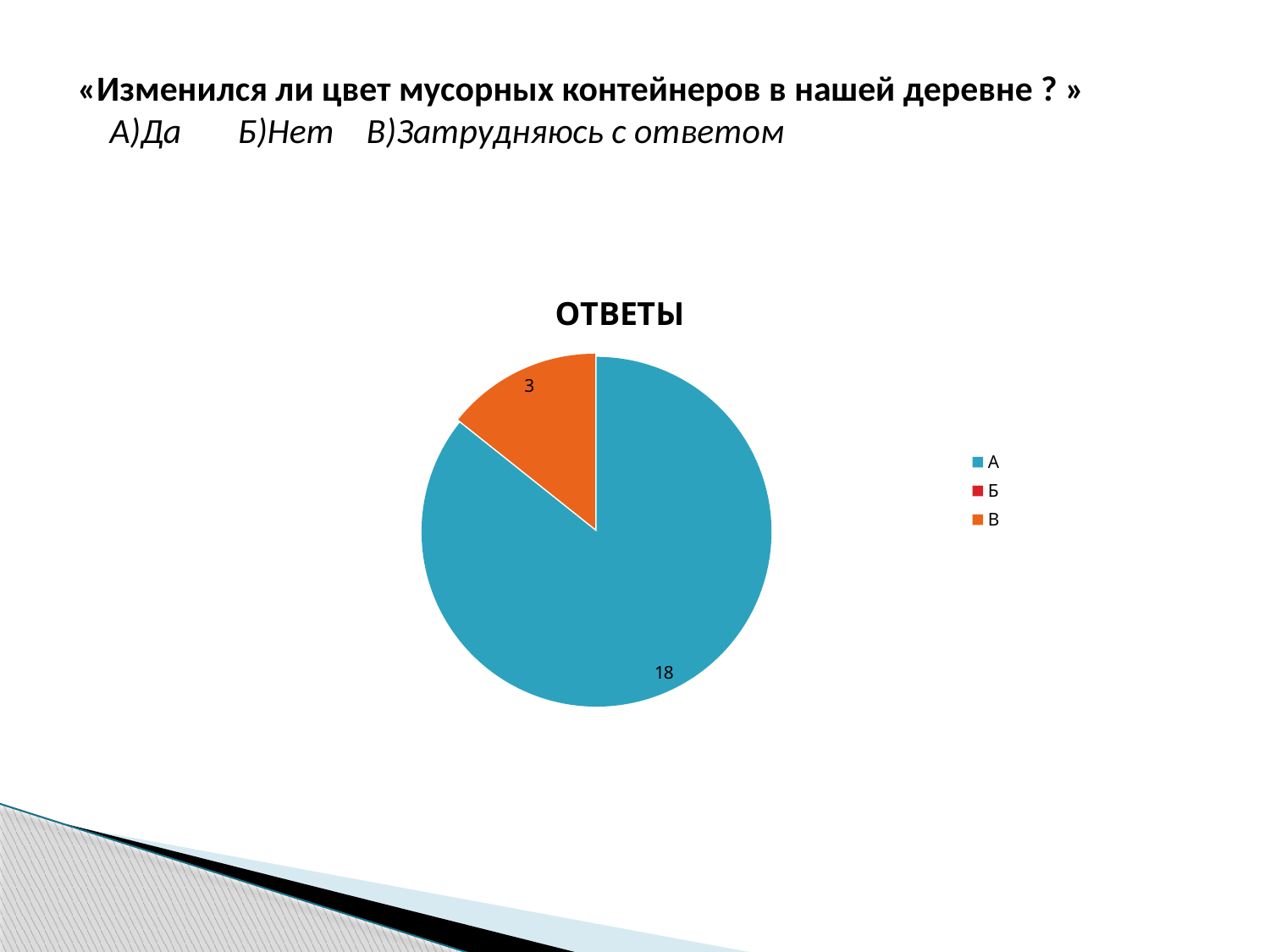
How many slices with data labels are visible in the pie chart? 2 What kind of chart is shown on the slide? Pie chart What is the difference between the values for A and В? 15 Which category has the largest slice in the pie chart? A What value is shown for category В in the pie chart? 3 What colour is the slice for category A? Blue What is the title of the chart? ОТВЕТЫ What value is shown for category A in the pie chart? 18 Which is larger, the value for A or the value for В? A How many entries does the legend of the chart list? 3